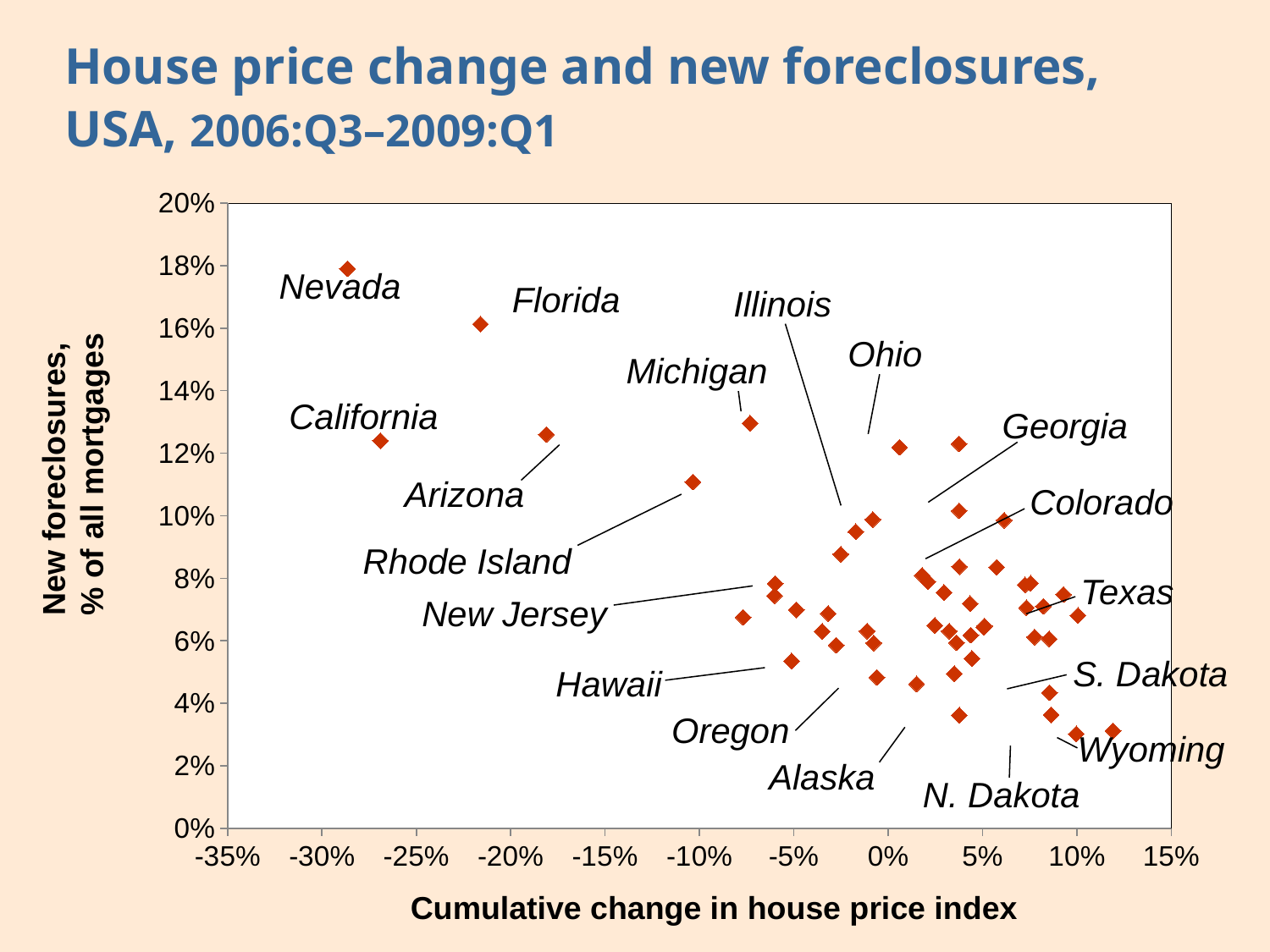
Is the new foreclosures value for Florida greater or less than 14%? greater Is the new foreclosures value for Wyoming greater or less than 4%? less Which has a higher rate of new foreclosures, Nevada or California? Nevada What time period does the chart title cover? 2006:Q3–2009:Q1 What is the label of the x axis? Cumulative change in house price index Is the cumulative change in house price index for California greater or less than -20%? less What kind of chart is shown on the slide? Scatter chart As the cumulative change in house price index increases along the x axis, do new foreclosures generally rise or fall? fall Which has a higher rate of new foreclosures, Texas or Wyoming? Texas Which labelled state has the highest rate of new foreclosures? Nevada